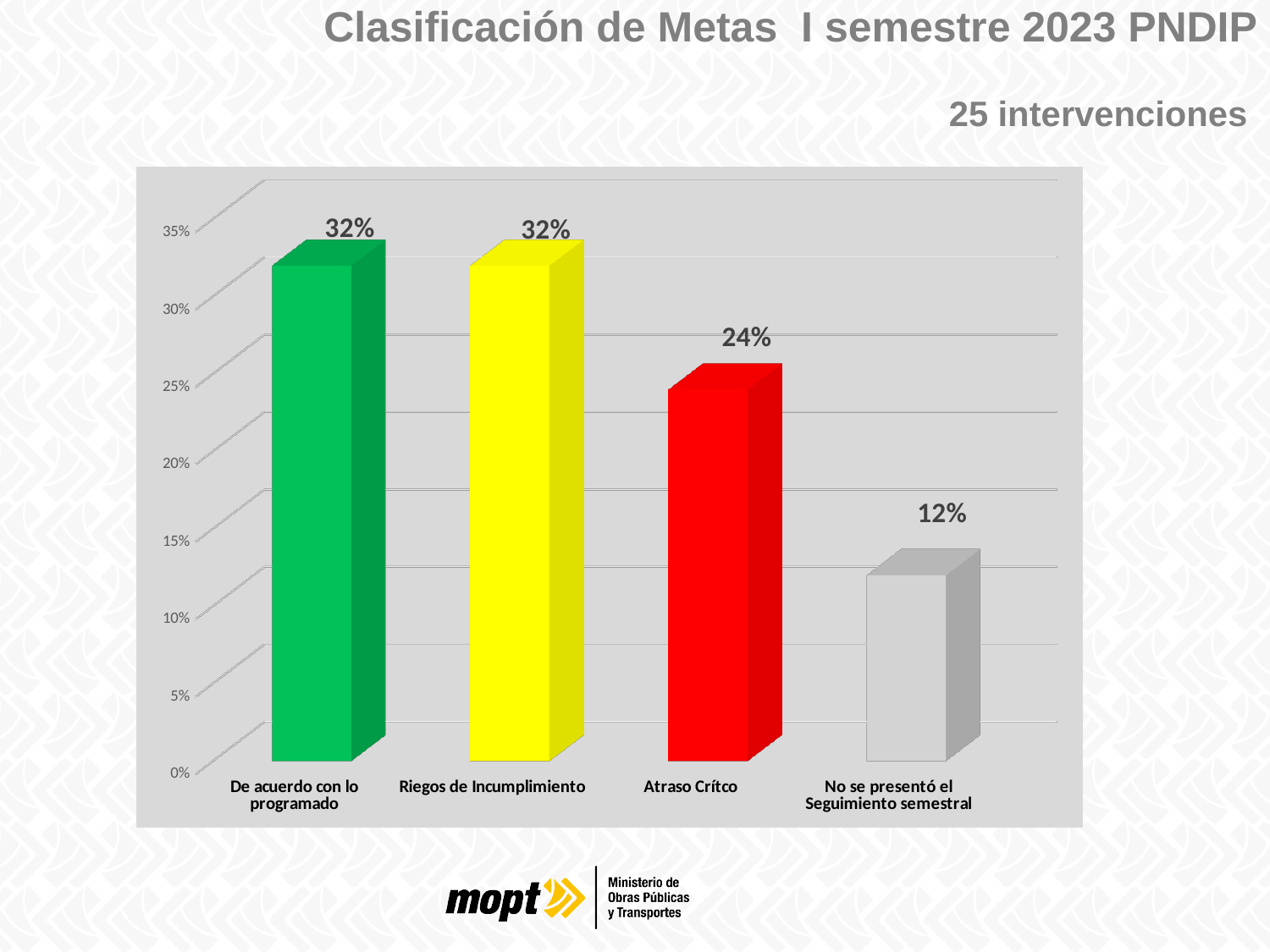
Do the values rise or fall from left to right across the categories? Fall What is the value for "De acuerdo con lo programado"? 32% How many categories are shown on the chart? 4 What is the difference between the values for "Atraso Crítco" and "No se presentó el Seguimiento semestral"? 12% What is the value for "No se presentó el Seguimiento semestral"? 12% What colour is the bar for "Atraso Crítco"? Red Is the value for "Atraso Crítco" greater or less than 20%? greater Which is larger, the value for "Atraso Crítco" or the value for "No se presentó el Seguimiento semestral"? Atraso Crítco Which category has the lowest value? No se presentó el Seguimiento semestral What kind of chart is shown on the slide? Bar chart What is the difference between the values for "Riegos de Incumplimiento" and "Atraso Crítco"? 8% What is the value for "Atraso Crítco"? 24%